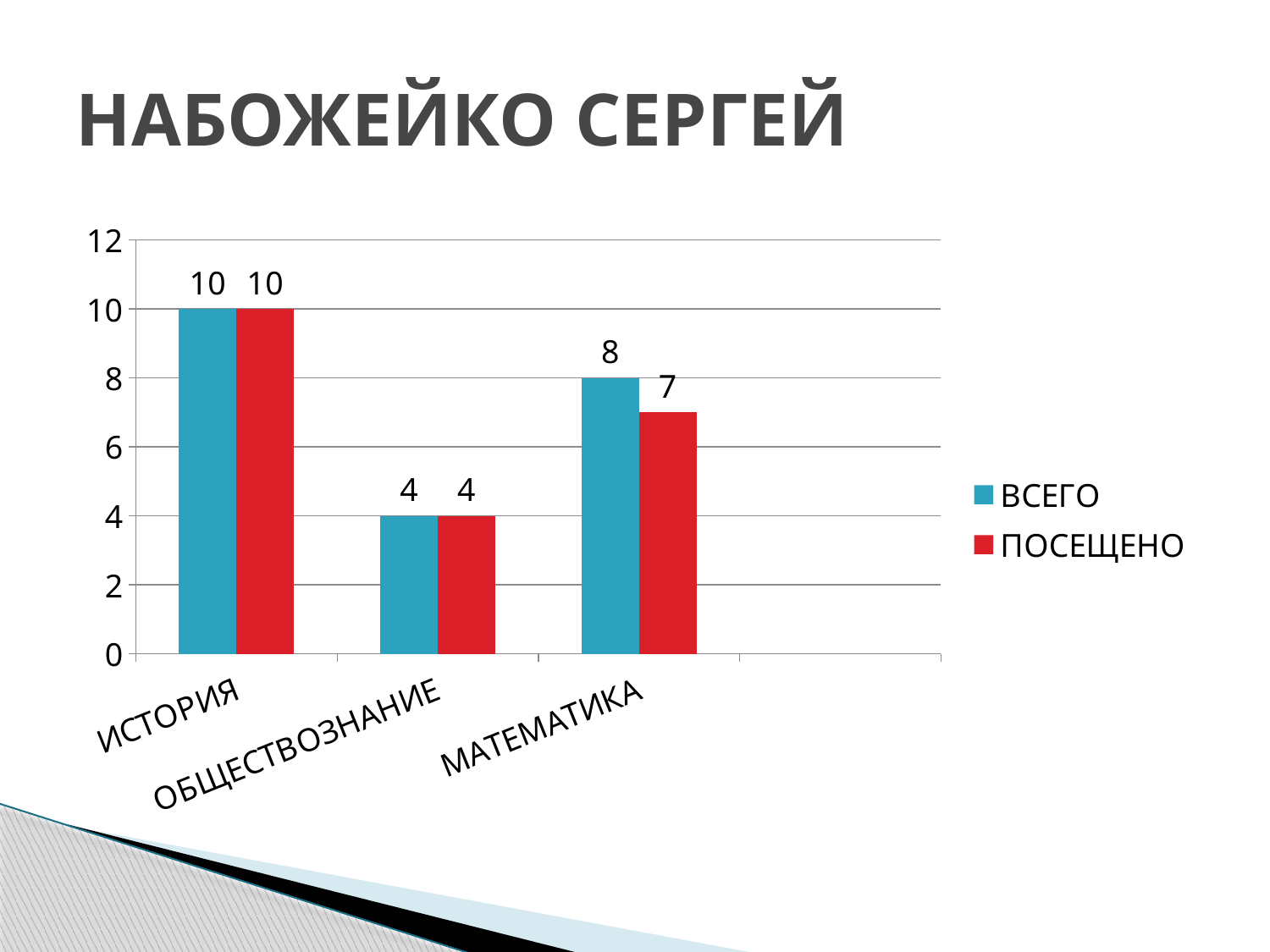
What is the ПОСЕЩЕНО value for МАТЕМАТИКА? 7 What kind of chart is shown on the slide? bar chart Which series is shown in red? ПОСЕЩЕНО Which category has the lowest ПОСЕЩЕНО value? ОБЩЕСТВОЗНАНИЕ Which category has the highest ВСЕГО value? ИСТОРИЯ How many series does the legend list? 2 Which is larger: the ВСЕГО value for МАТЕМАТИКА or the ВСЕГО value for ОБЩЕСТВОЗНАНИЕ? МАТЕМАТИКА What is the difference between the ВСЕГО and ПОСЕЩЕНО values for МАТЕМАТИКА? 1 What is the ВСЕГО value for ОБЩЕСТВОЗНАНИЕ? 4 What is the difference between the ВСЕГО values for ИСТОРИЯ and ОБЩЕСТВОЗНАНИЕ? 6 How many categories are shown on the x axis? 3 What is the ВСЕГО value for ИСТОРИЯ? 10